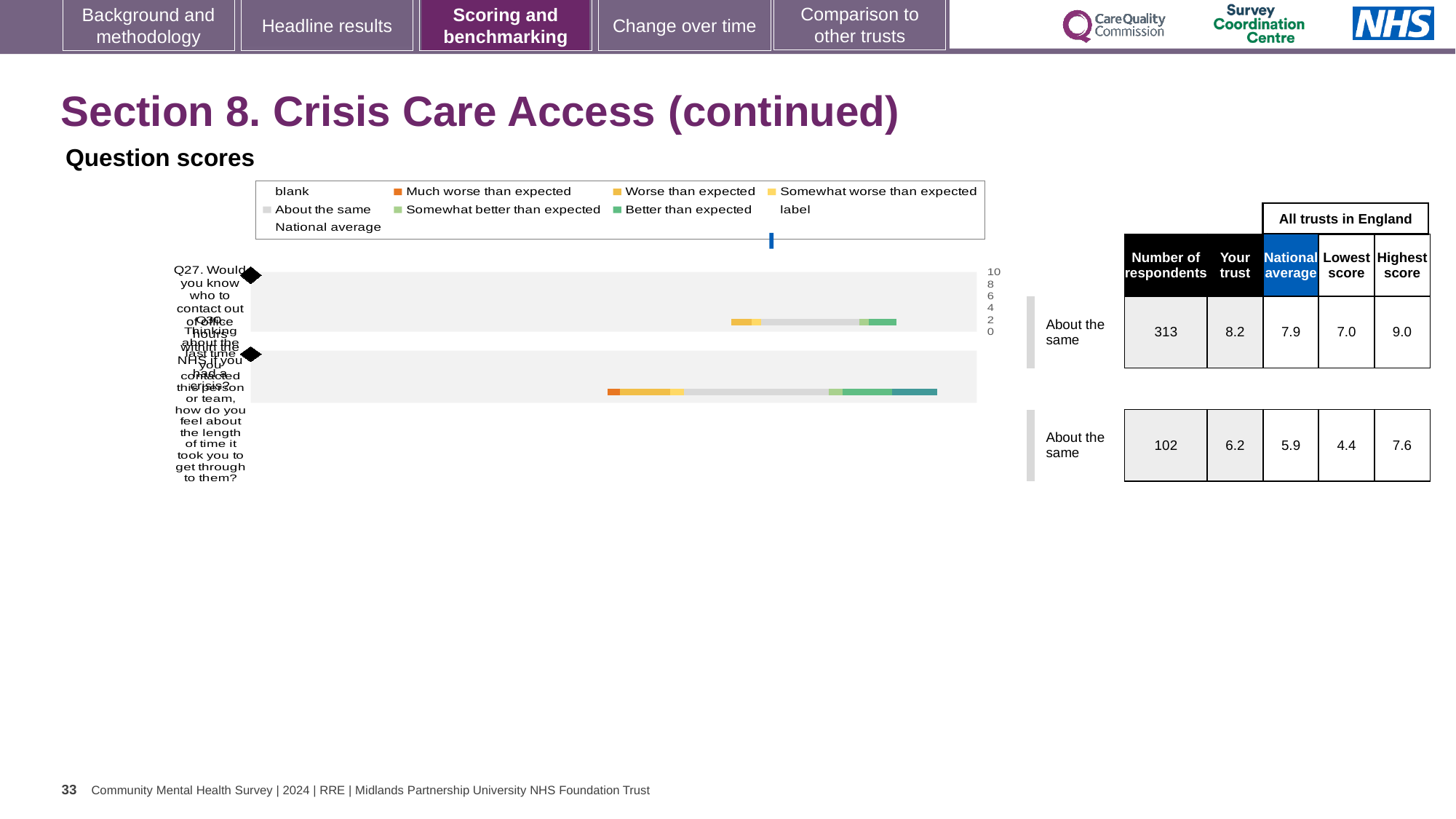
What is the Lowest score across all trusts in England for Q27? 7.0 In the Question scores table, what is the National average for Q30 (how do you feel about the length of time it took you to get through to them?)? 5.9 In the chart legend, which colour represents 'Much worse than expected'? orange What kind of chart is shown under 'Question scores'? bar chart How many questions (bars) are plotted in the Question scores chart? 2 What is the Highest score across all trusts in England for Q30? 7.6 Which question has the higher 'Your trust' score, Q27 or Q30? Q27 How many respondents answered Q27 according to the table next to the chart? 313 What benchmark category is shown for both Q27 and Q30 in the Question scores chart? About the same What is the difference between the 'Your trust' score and the National average for Q27? 0.3 In the Question scores table, what is the 'Your trust' score for Q27 (Would you know who to contact out of office hours within the NHS if you had a crisis?)? 8.2 How many more respondents answered Q27 than Q30? 211